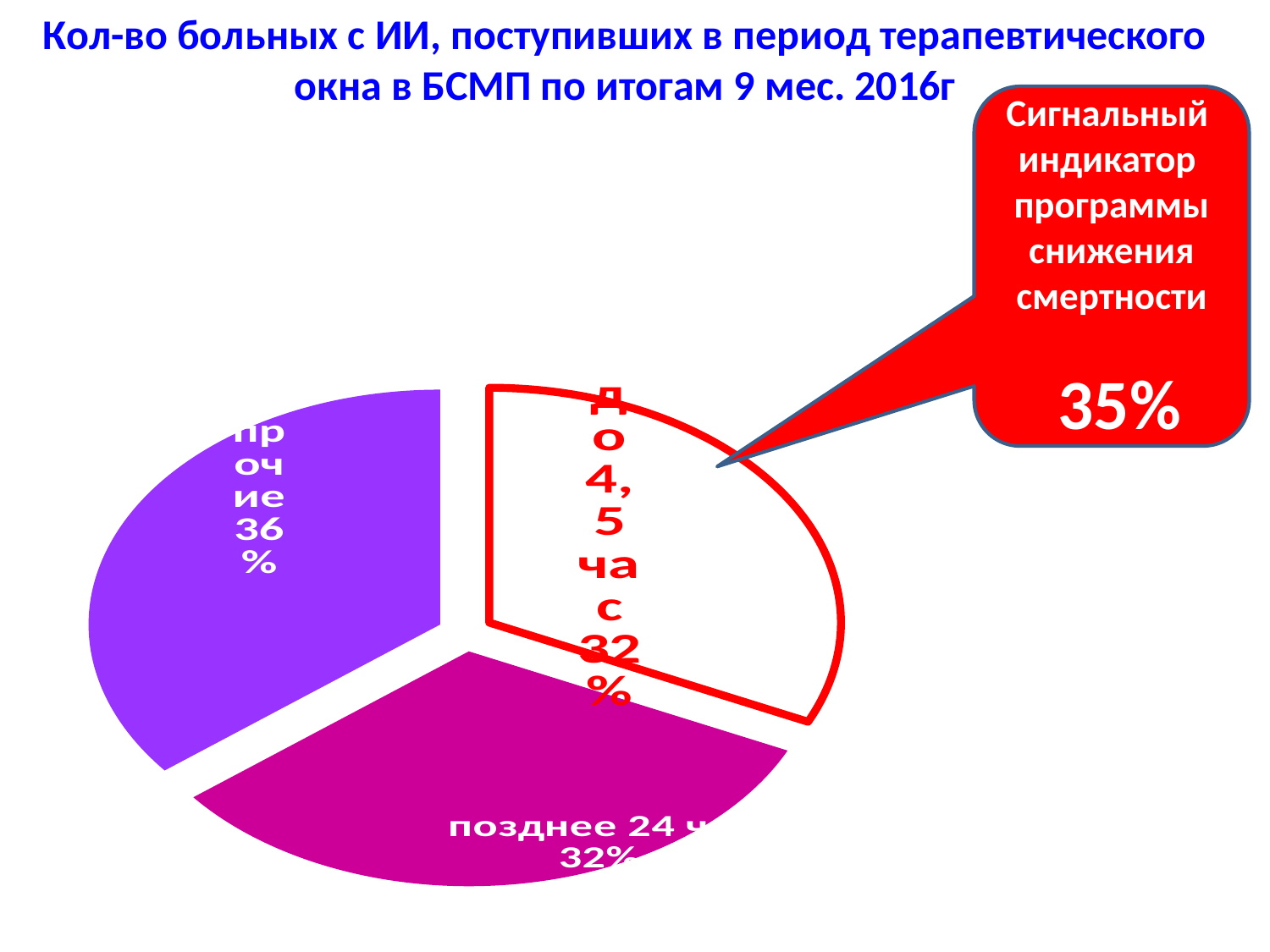
What is the value shown for the "до 4,5 час" slice? 32% What kind of chart is shown on the slide? pie chart What share of the pie does the "прочие" slice represent? 36% Is the value for "прочие" greater or less than 30%? greater How many slices does the pie chart have? 3 What target value is shown in the red callout labelled "Сигнальный индикатор программы снижения смертности"? 35% What is the value shown for the "позднее 24 ч" slice? 32% Which slice of the pie chart is outlined in red and pointed to by the callout? до 4,5 час Which slice of the pie chart is the largest? прочие Which is larger, the "прочие" slice or the "позднее 24 ч" slice? прочие What is the difference in percentage points between the "прочие" slice and the "до 4,5 час" slice? 4